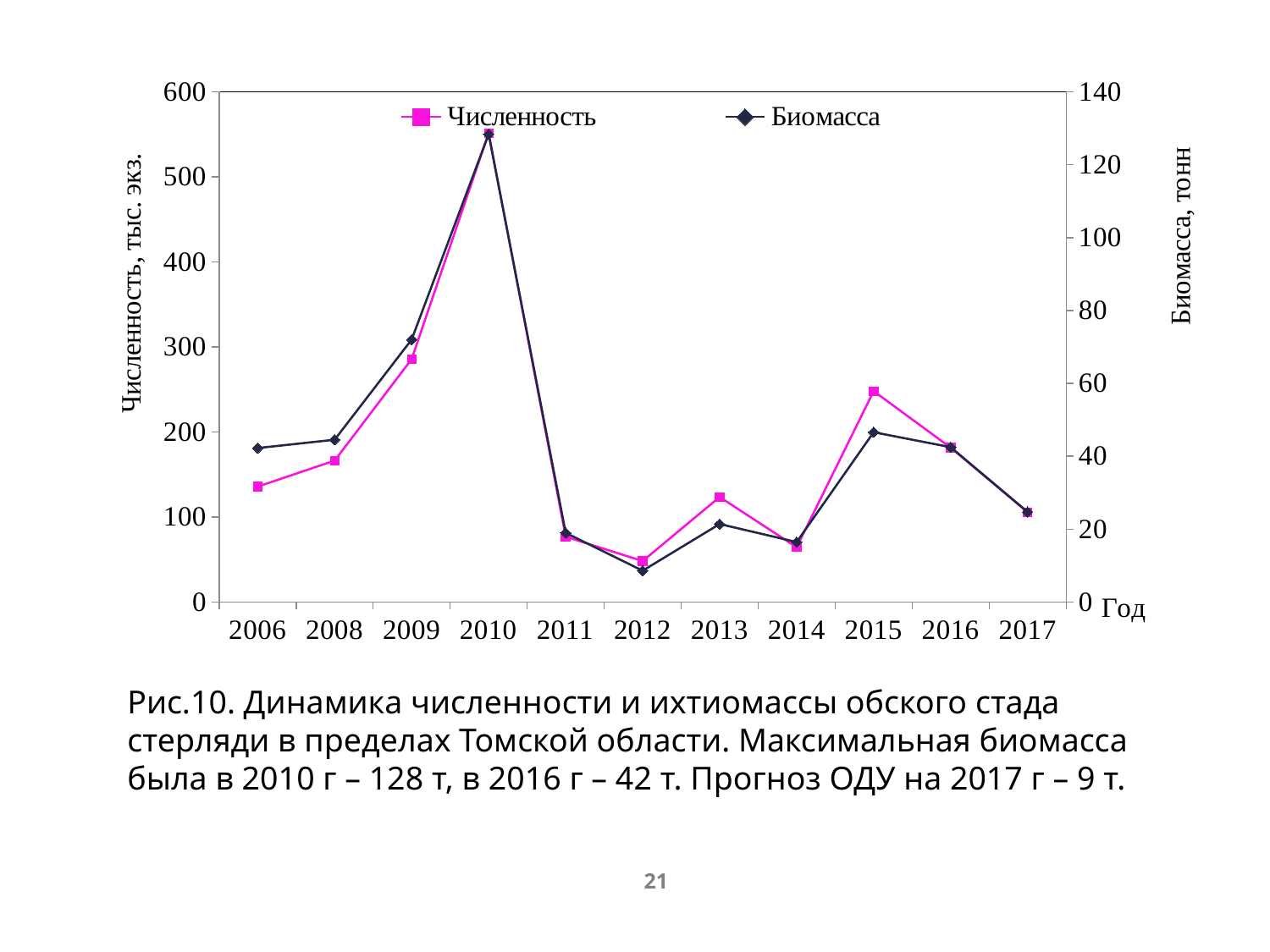
In which year does the Численность series reach its highest value? 2010 Is the Численность value for 2006 greater or less than 200? less Is the Численность value for 2010 greater or less than 500? greater How many series does the legend list? 2 Do the values of both series rise or fall from 2010 to 2012? fall In which year is the Биомасса series at its lowest? 2012 What kind of chart is shown on the slide? line chart Which year has the larger Численность value, 2013 or 2015? 2015 How many years are plotted along the x axis? 11 Is the Численность value for 2015 greater or less than 200? greater What is the label of the right-hand vertical axis? Биомасса, тонн